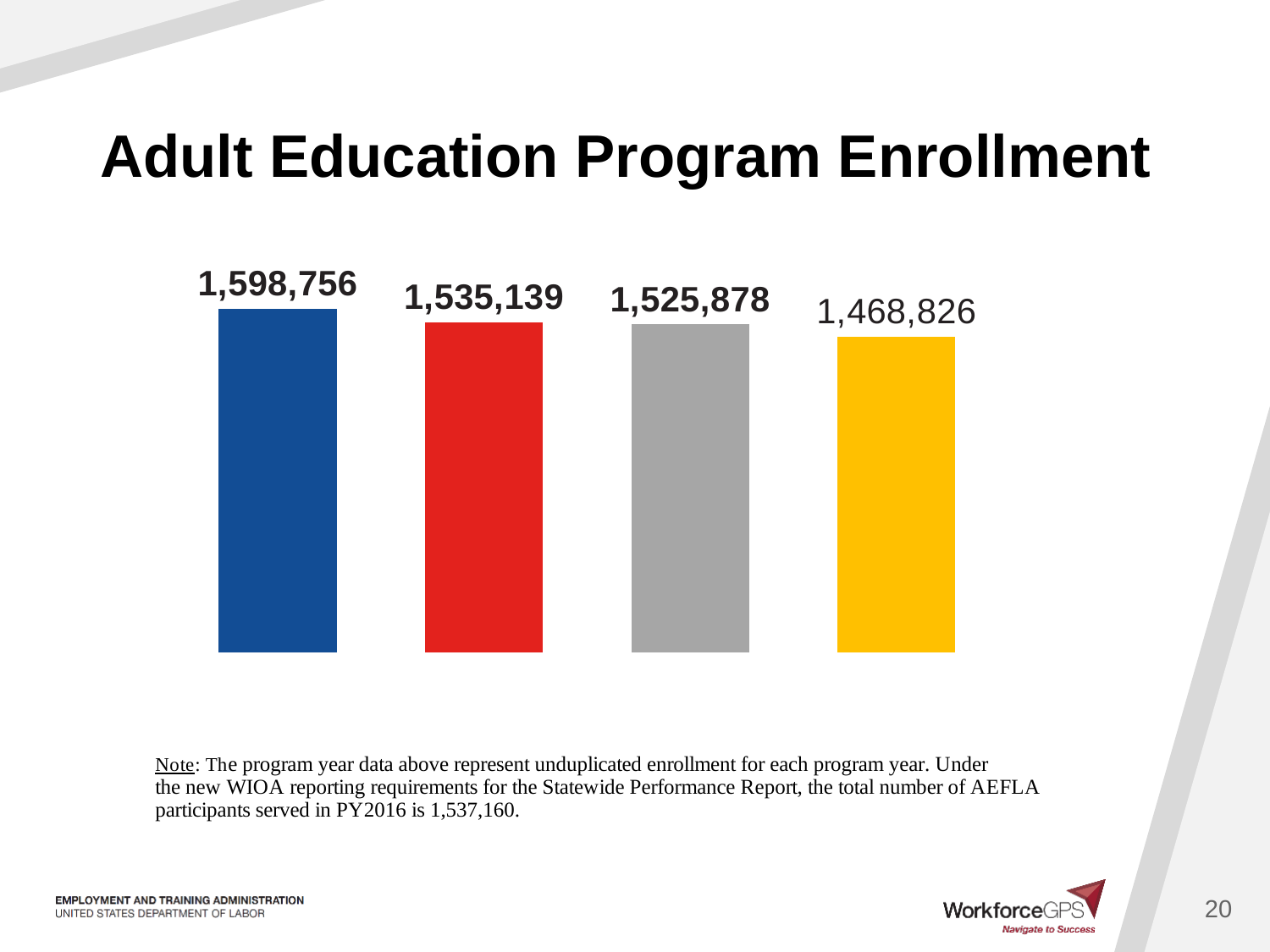
What is the value shown on the first (blue) bar? 1,598,756 Do the values rise or fall from left to right across the bars? Fall What is the value shown on the fourth (yellow) bar? 1,468,826 What is the difference between the first (blue) bar and the fourth (yellow) bar? 129,930 What type of chart is shown on the slide? Bar chart Which bar has the lowest value? The fourth (yellow) bar, 1,468,826 How many bars are plotted in the chart? 4 What is the value shown on the third (grey) bar? 1,525,878 What is the difference between the second (red) bar and the third (grey) bar? 9,261 What is the value shown on the second (red) bar? 1,535,139 Which is larger, the value of the first (blue) bar or the second (red) bar? The first (blue) bar Which bar has the highest value? The first (blue) bar, 1,598,756